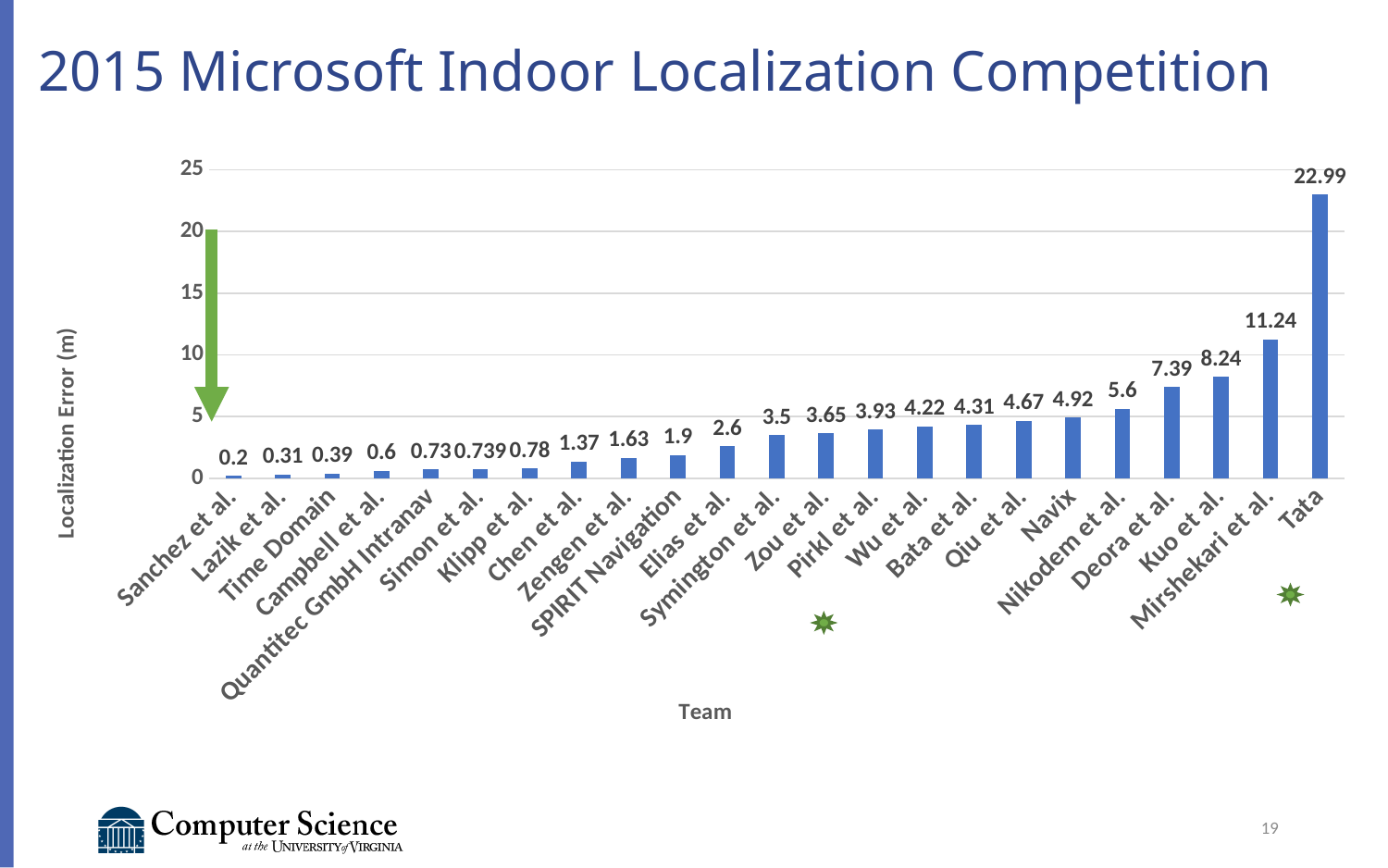
Do the localization error values rise or fall from left to right along the x axis? Rise Which has a larger localization error, Kuo et al. or Deora et al.? Kuo et al. Which team has the highest localization error? Tata Is the localization error for Nikodem et al. greater or less than 5? greater What is the localization error for Tata? 22.99 What is the localization error for Sanchez et al.? 0.2 What kind of chart is shown on the slide? Bar chart How many teams are shown on the chart? 23 What is the difference in localization error between Tata and Mirshekari et al.? 11.75 What is the localization error for Navix? 4.92 Which team has the lowest localization error? Sanchez et al. What is the localization error for SPIRIT Navigation? 1.9